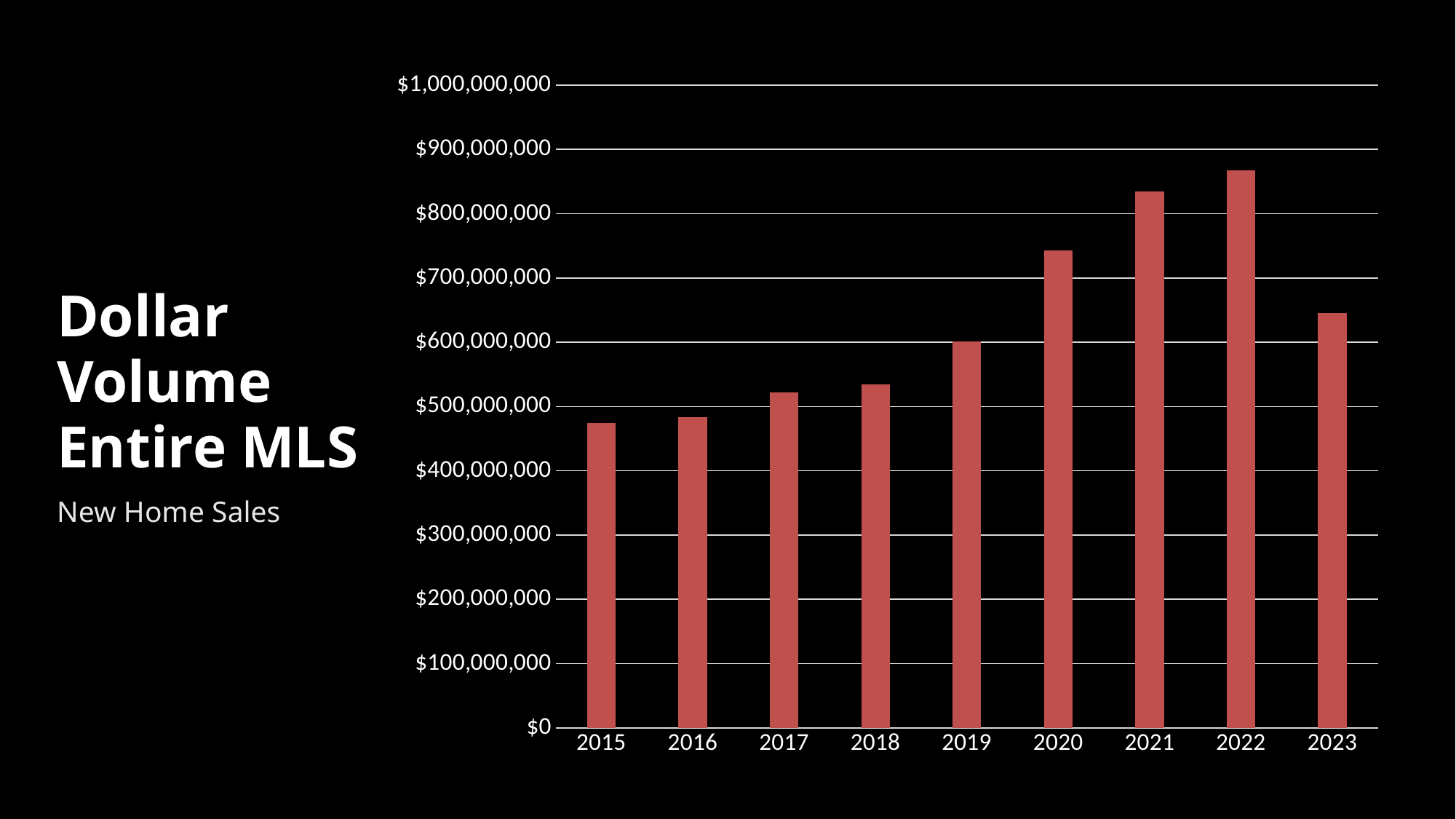
How many years are shown on the x axis of the chart? 9 What kind of chart is shown on the slide? bar chart Is the value for 2017 greater or less than $500,000,000? greater Which is larger, the value for 2021 or the value for 2023? 2021 Is the value for 2020 greater or less than $700,000,000? greater Is the value for 2015 greater or less than $500,000,000? less What is the title shown on the slide for this chart? Dollar Volume Entire MLS What is the highest tick label on the vertical axis? $1,000,000,000 Do the values rise or fall from 2015 to 2022? rise Which year has the highest dollar volume in the chart? 2022